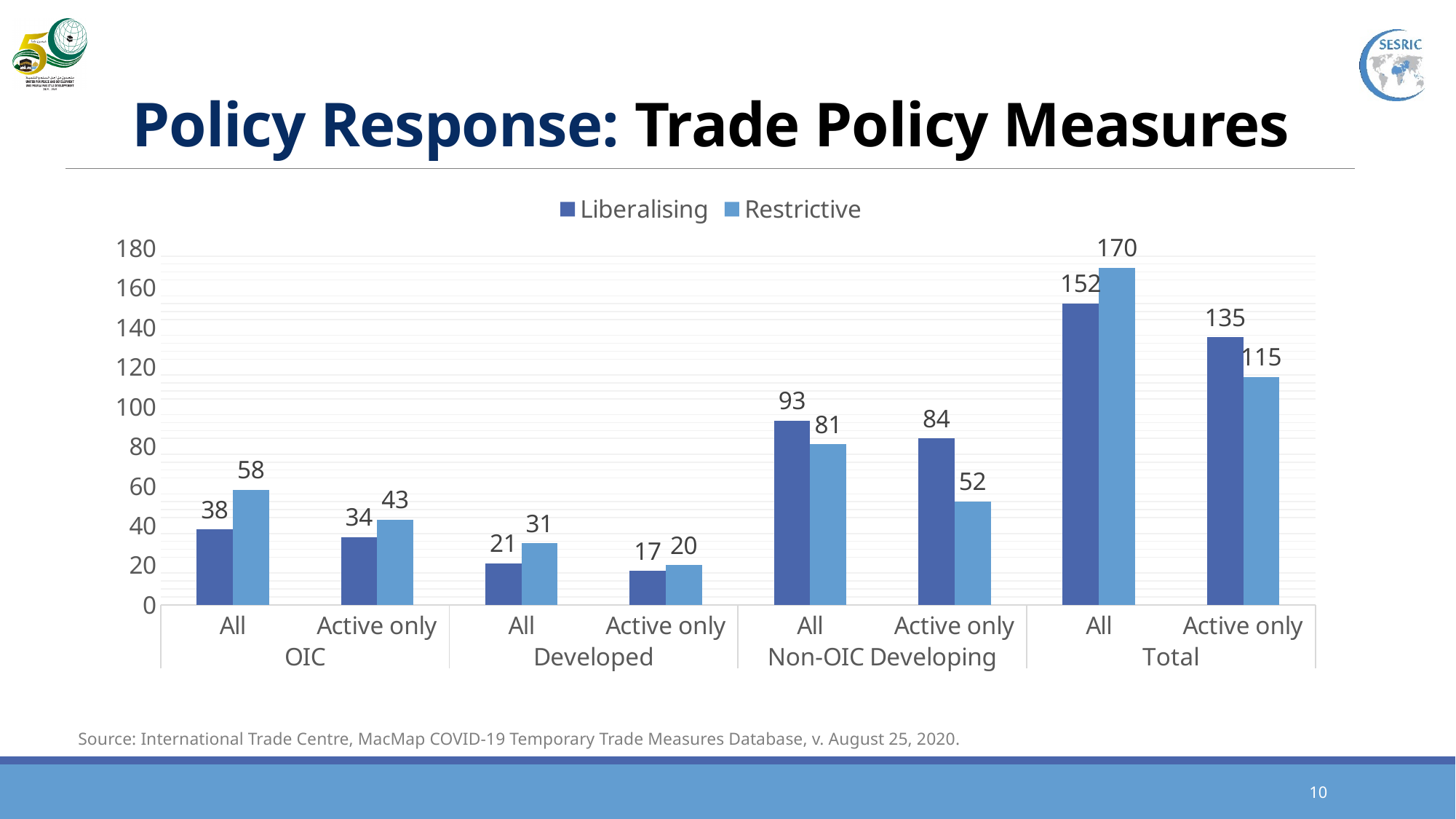
Which category has the lowest Liberalising value? Developed, Active only Which category has the highest Restrictive value? Total, All What is the difference between the Liberalising values for OIC, All and OIC, Active only? 4 How many category groups are shown along the x axis? 4 What is the difference between the Restrictive and Liberalising values for Total, All? 18 What kind of chart is shown on the slide? Bar chart What is the Liberalising value for Developed, Active only? 17 What is the Liberalising value for Non-OIC Developing, All? 93 How many series does the legend list? 2 What is the Restrictive value for Total, Active only? 115 What is the Restrictive value for OIC, All? 58 For Non-OIC Developing, Active only, which is larger: Liberalising or Restrictive? Liberalising